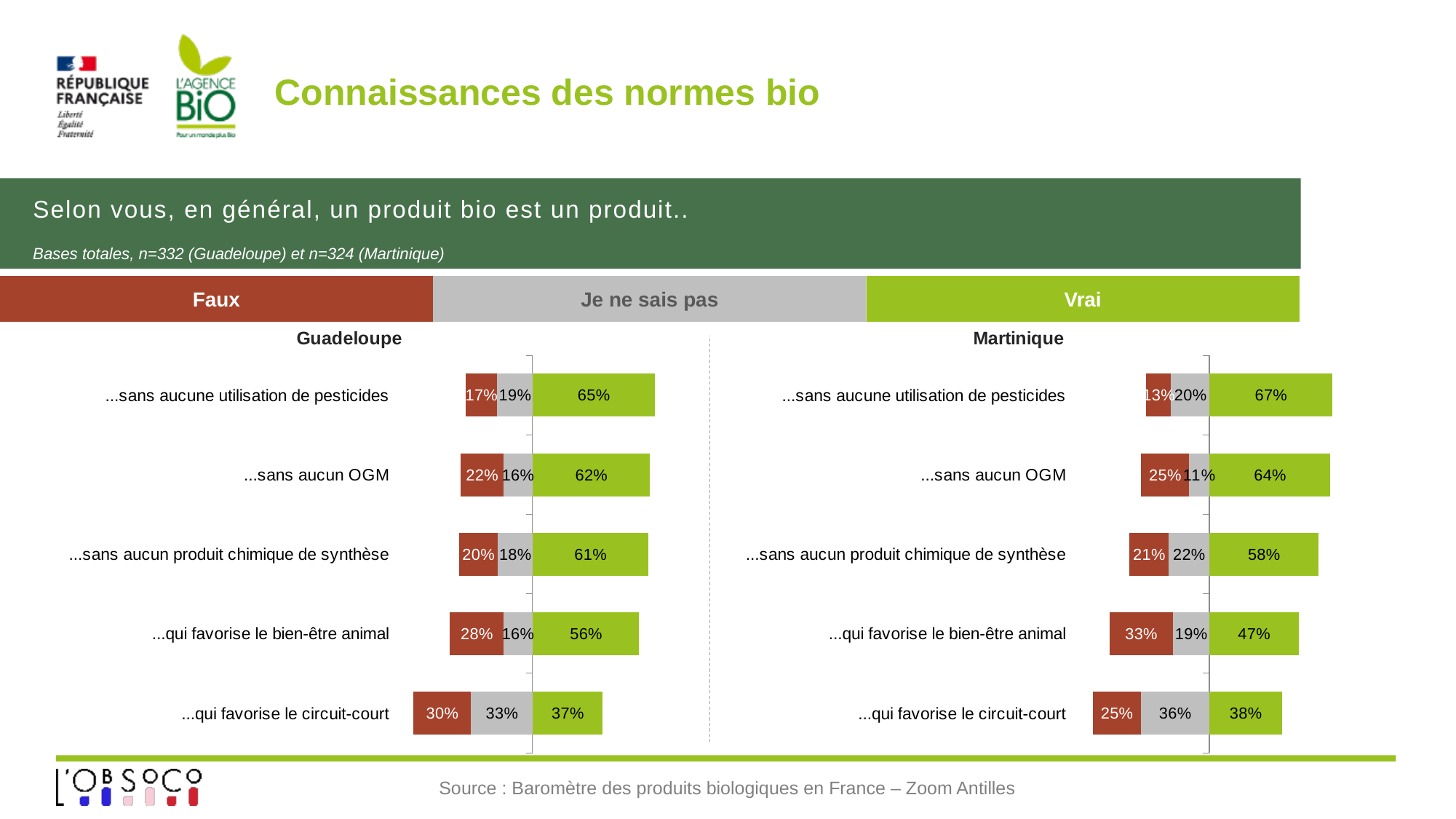
In the Martinique chart, what percentage answered "Faux" for "...qui favorise le bien-être animal"? 33% What type of chart is used for the Martinique data? Stacked bar chart Which colour represents the "Faux" response in the charts? Red-brown In the Guadeloupe chart, what is the difference between the "Vrai" percentages for "...sans aucun OGM" and "...qui favorise le circuit-court"? 25 percentage points How many response categories does the legend above the charts list? 3 How many items are listed in the Guadeloupe chart? 5 Which is larger: the "Vrai" percentage for "...sans aucun produit chimique de synthèse" in the Guadeloupe chart or in the Martinique chart? Guadeloupe In the Martinique chart, what is the total of the three percentages for "...sans aucun OGM"? 100% In the Martinique chart, what percentage answered "Je ne sais pas" for "...qui favorise le circuit-court"? 36% In the Guadeloupe chart, what percentage answered "Vrai" for "...sans aucune utilisation de pesticides"? 65% In the Martinique chart, which item has the lowest "Vrai" percentage? ...qui favorise le circuit-court In the Guadeloupe chart, which item has the highest "Vrai" percentage? ...sans aucune utilisation de pesticides